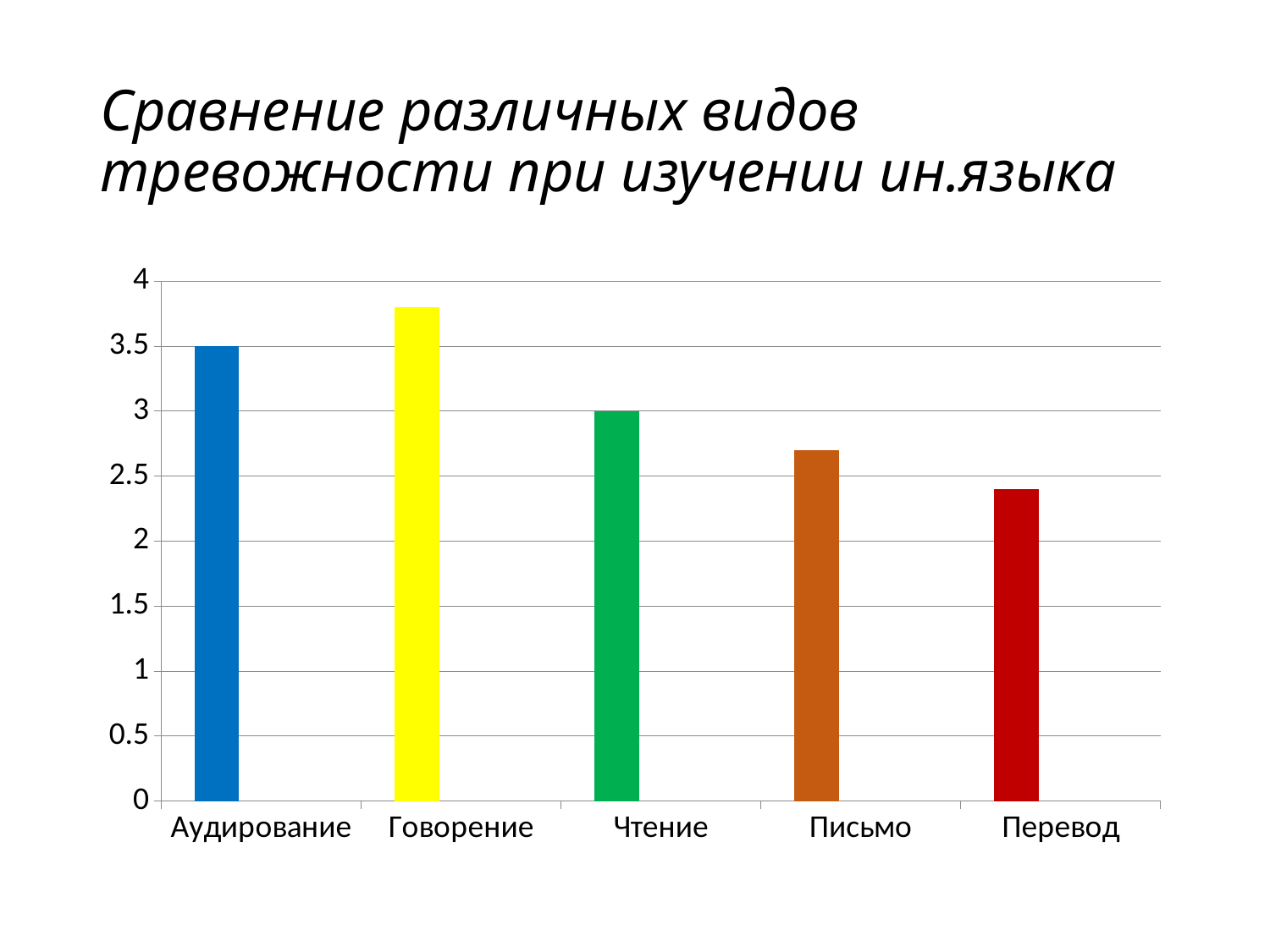
What is the difference between the values for Аудирование and Чтение? 0.5 What colour is the bar for Говорение? yellow What type of chart is shown on the slide? bar chart How many categories are shown on the x axis of the chart? 5 What is the value for Аудирование? 3.5 Is the value for Говорение greater or less than 3.5? greater Which category has the highest value? Говорение Which category has the lowest value? Перевод Which is larger, the value for Письмо or the value for Перевод? Письмо What is the value for Чтение? 3 Is the value for Письмо greater or less than 2.5? greater Is the value for Перевод greater or less than 2.5? less